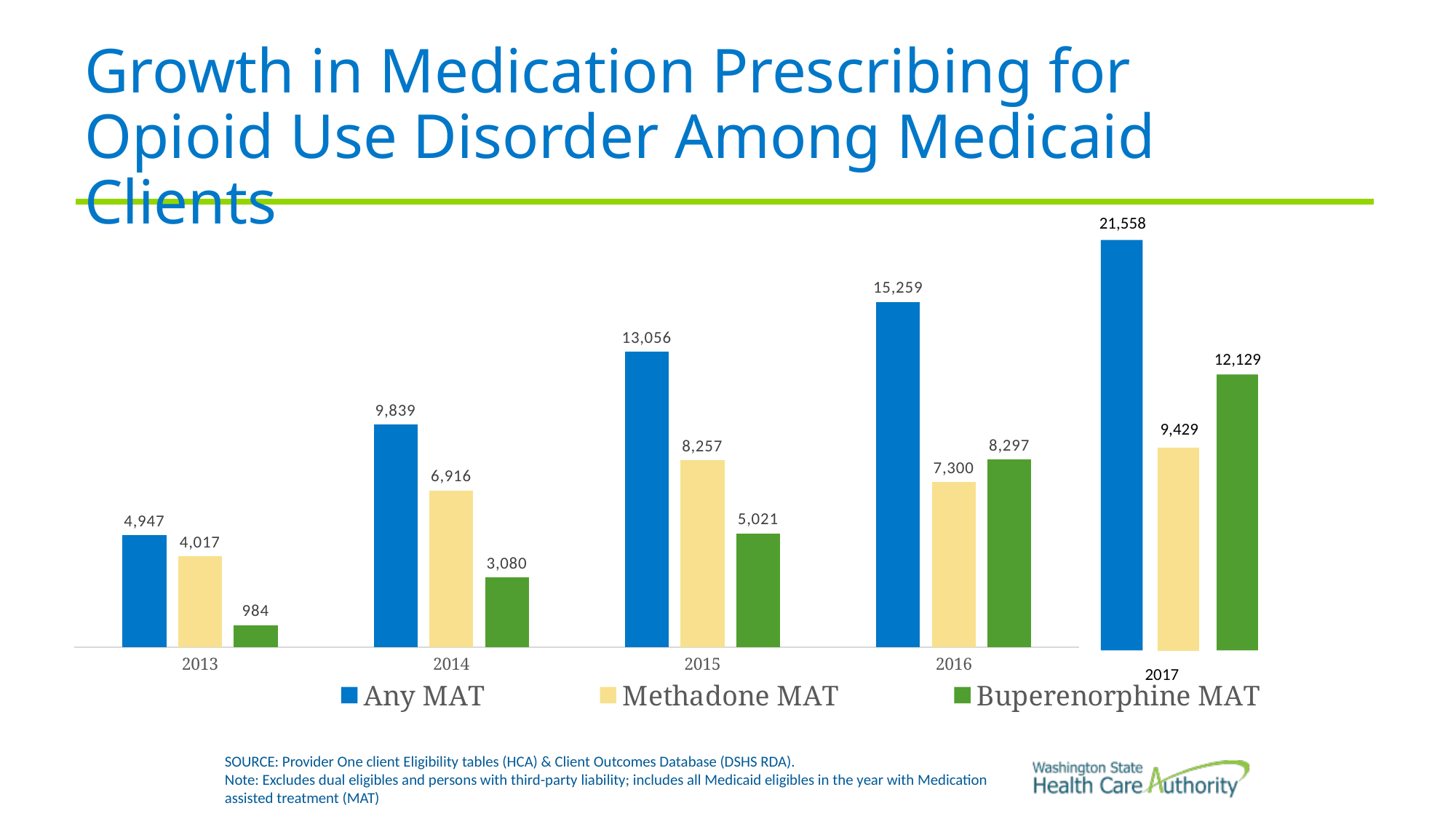
In which year is the Buperenorphine MAT value lowest? 2013 Do the Any MAT values rise or fall from 2013 to 2017? Rise What kind of chart is shown on the slide? Bar chart What is the value for Methadone MAT in 2015? 8,257 In which year is the Any MAT value highest? 2017 How many series does the legend list? 3 Which is larger in 2016, Methadone MAT or Buperenorphine MAT? Buperenorphine MAT What is the value for Buperenorphine MAT in 2013? 984 What is the value for Any MAT in 2017? 21,558 Which is larger in 2014, Methadone MAT or Buperenorphine MAT? Methadone MAT How many years are shown on the x axis? 5 What is the difference between Any MAT in 2017 and Any MAT in 2016? 6,299